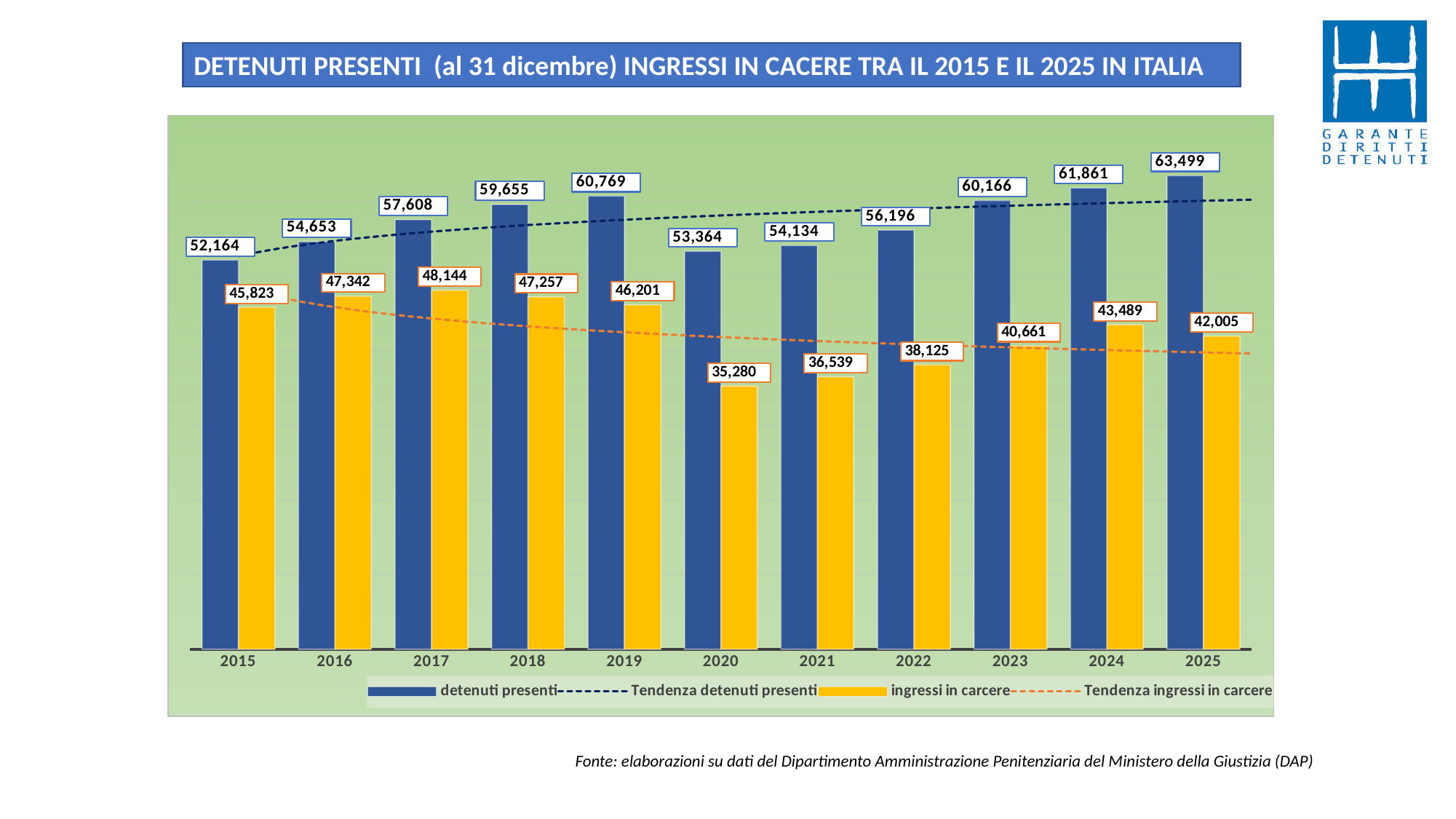
In which year is ingressi in carcere lowest? 2020 What is the difference between detenuti presenti and ingressi in carcere in 2025? 21,494 What is the value of detenuti presenti for 2019? 60,769 What is the value of ingressi in carcere for 2024? 43,489 In which year is detenuti presenti highest? 2025 What is the value of ingressi in carcere for 2020? 35,280 How many entries does the legend list? 4 In which year is ingressi in carcere highest? 2017 Does the trend line for ingressi in carcere rise or fall from 2015 to 2025? Fall Which is larger, detenuti presenti in 2020 or detenuti presenti in 2023? 2023 What kind of chart is shown on the slide? Bar chart How many years are shown on the x axis? 11